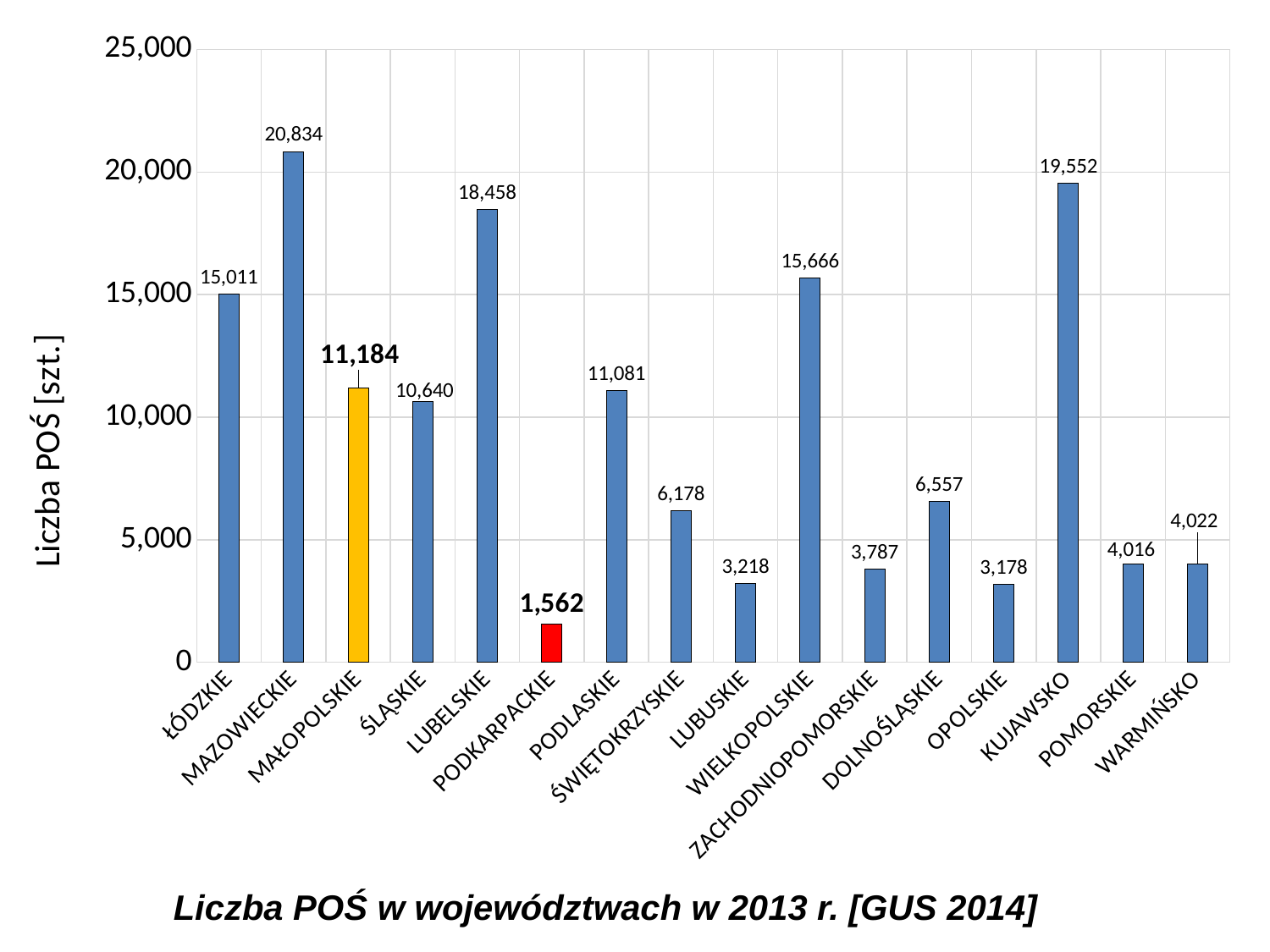
Is the value for ŁÓDZKIE greater or less than 10,000? greater Which is larger, the value for LUBELSKIE or the value for WIELKOPOLSKIE? LUBELSKIE What is the value for PODKARPACKIE? 1,562 Which voivodeship has the highest value? MAZOWIECKIE What is the difference between the values for MAZOWIECKIE and KUJAWSKO? 1,282 Which bar is coloured red? PODKARPACKIE Which voivodeship has the lowest value? PODKARPACKIE What is the value for MAŁOPOLSKIE? 11,184 What is the label of the y axis? Liczba POŚ [szt.] What kind of chart is shown on the slide? bar chart What is the value for MAZOWIECKIE? 20,834 How many voivodeships are shown on the x axis? 16